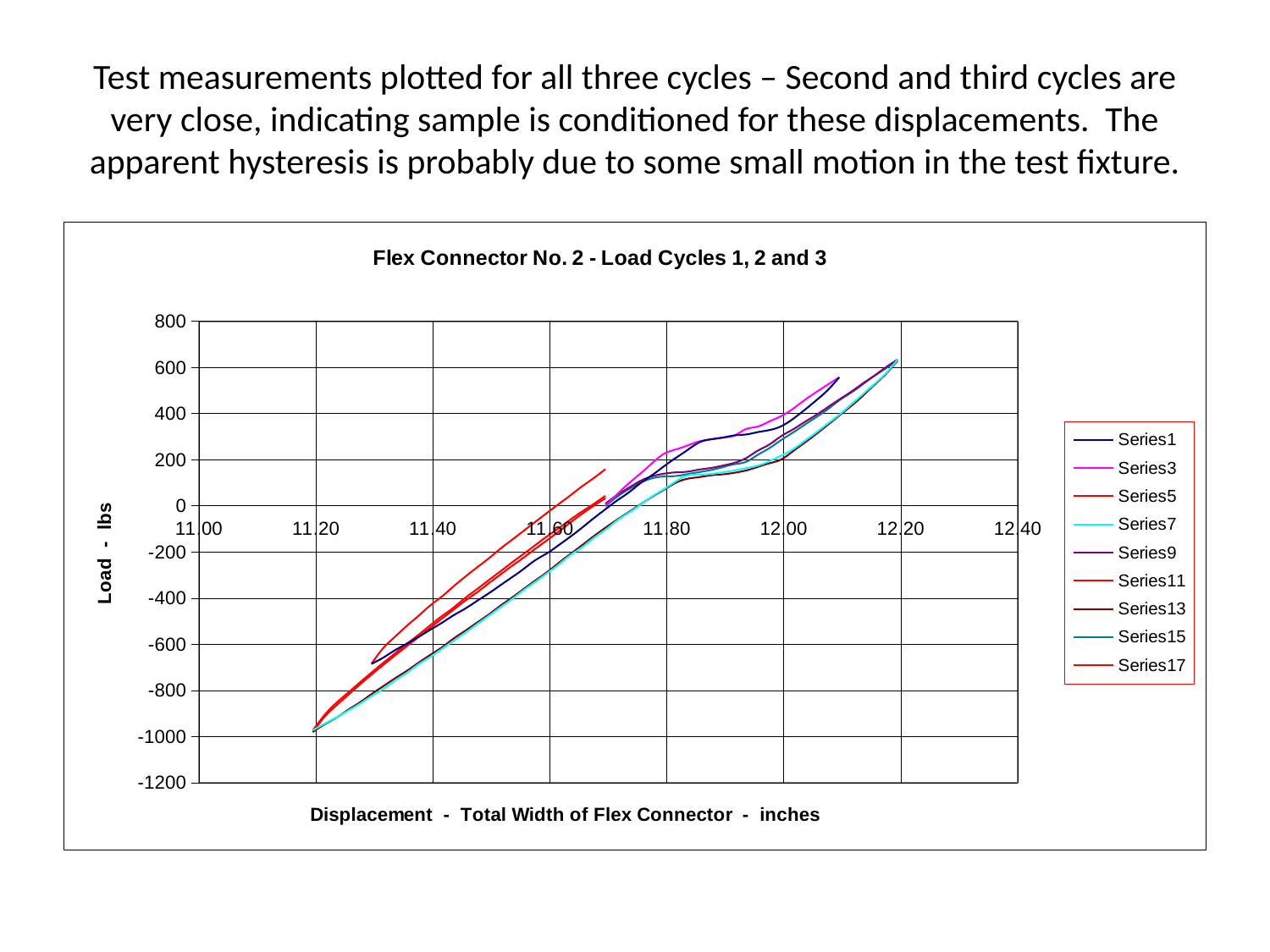
Is the lowest load value plotted on the chart greater or less than -1200? greater How many series does the legend list? 9 What is the title of the chart? Flex Connector No. 2 - Load Cycles 1, 2 and 3 Is the load for Series1 at a displacement of 12.00 greater or less than 0? greater What kind of chart is shown on the slide? line chart Is the lowest load value plotted on the chart greater or less than -800? less What is the label of the vertical axis? Load - lbs Do the plotted load values rise or fall as displacement increases along the x axis? rise